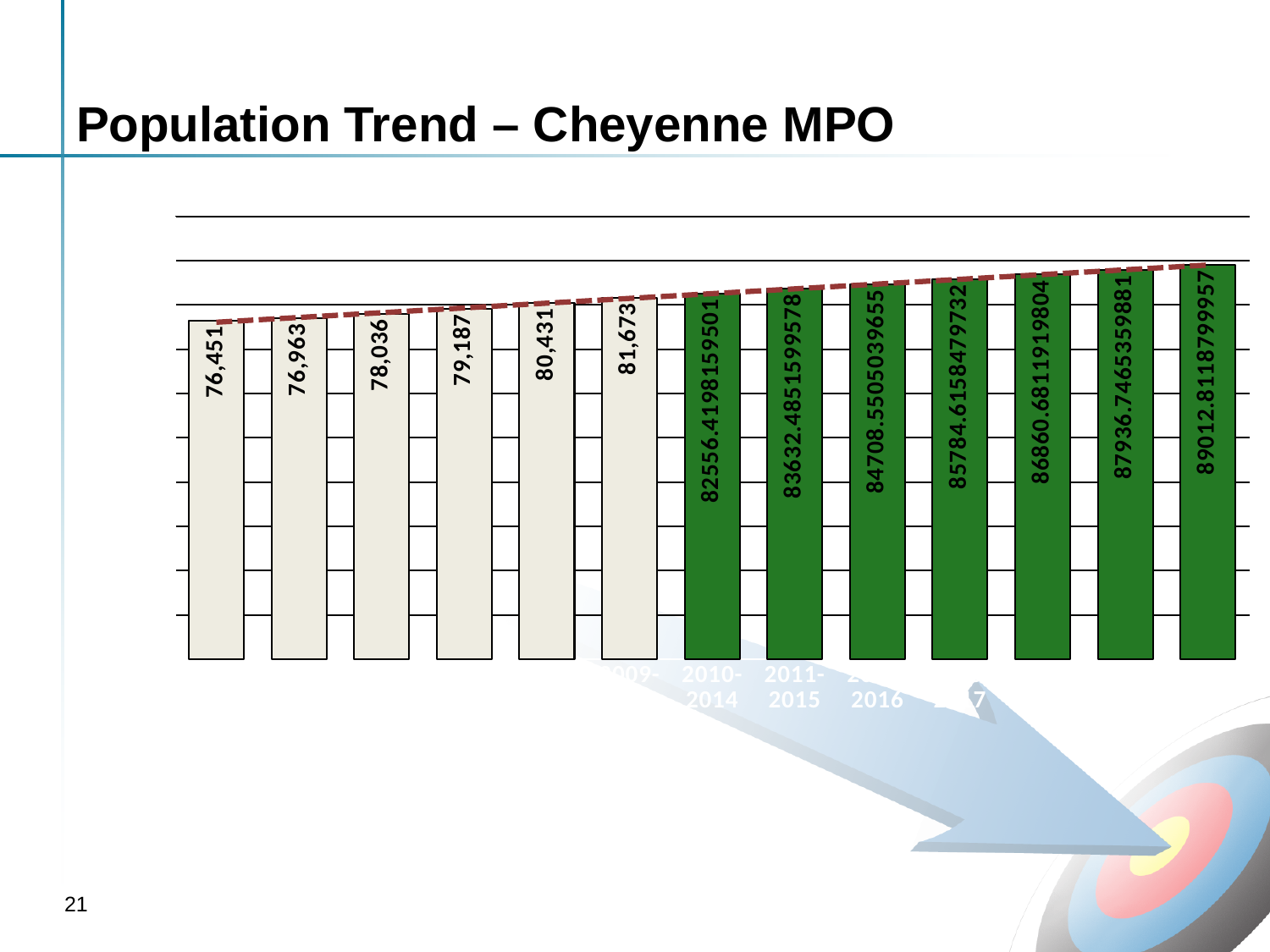
What is the value of the bar labelled 2010-2014? 82556.4198159501 What is the value shown on the rightmost bar of the chart? 89012.8118799957 What is the value of the bar labelled 2011-2015? 83632.4851599578 Which bar has the lowest value? The leftmost bar (76,451) Do the values rise or fall from left to right across the chart? Rise What is the value of the sixth bar from the left (the last beige bar)? 81,673 What is the difference between the second bar (76,963) and the first bar (76,451)? 512 What type of chart is shown on the slide? Bar chart What is the title of the slide containing the chart? Population Trend – Cheyenne MPO How many bars are plotted in the chart? 13 What is the value shown on the leftmost bar of the chart? 76,451 Which bar has the highest value? The rightmost bar (89012.8118799957)